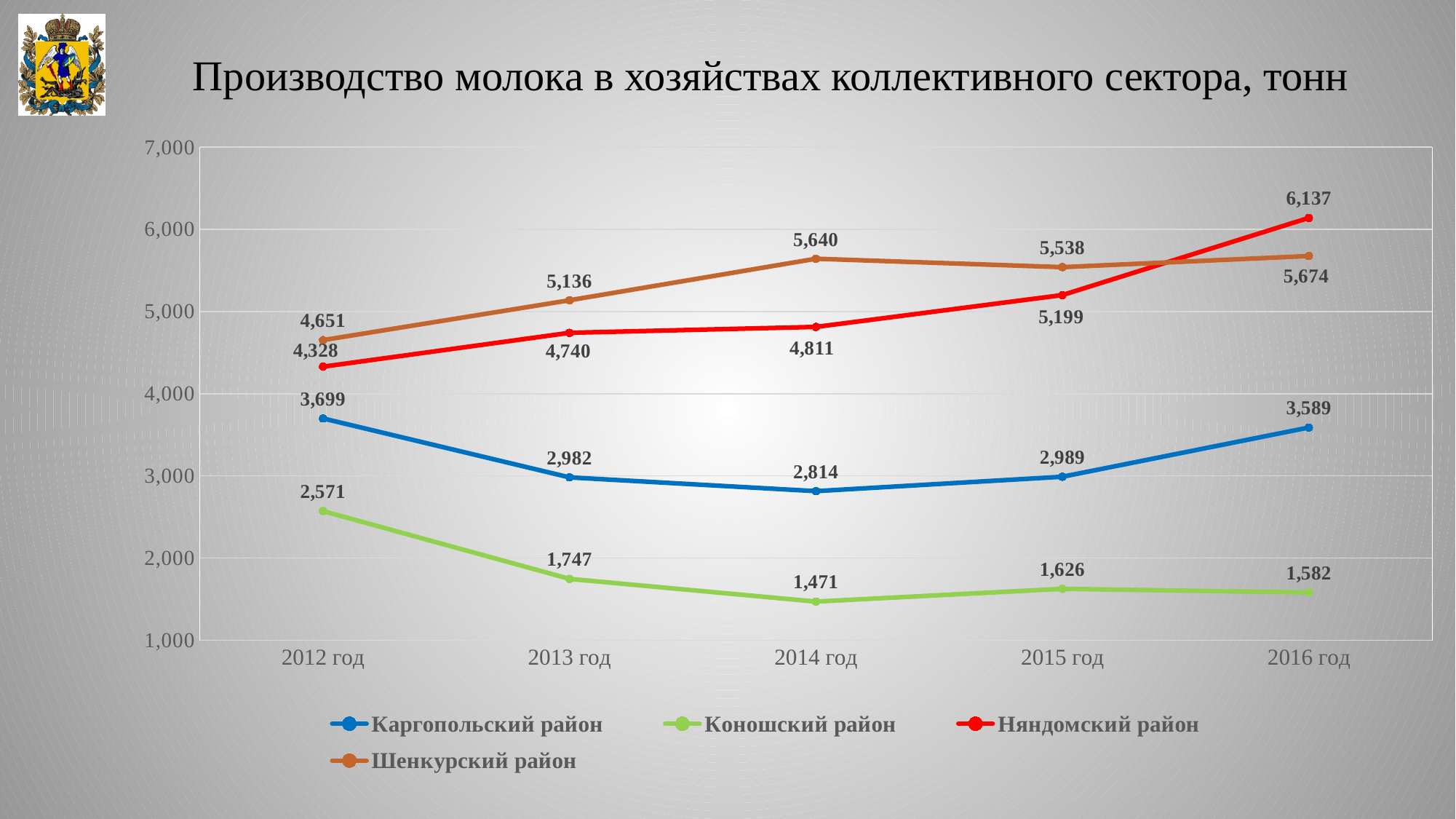
How many years are shown on the x axis? 5 In which year did Коношский район have its lowest value? 2014 год What is the difference between the 2012 год and 2016 год values for Каргопольский район? 110 Does the value for Няндомский район rise or fall from 2012 год to 2016 год? Rises What was milk production in Няндомский район in 2016 год? 6,137 By how much did the value for Няндомский район increase from 2015 год to 2016 год? 938 How many series does the legend list? 4 What kind of chart is shown on the slide? Line chart What value is shown for Шенкурский район in 2013 год? 5,136 What value is shown for Коношский район in 2014 год? 1,471 In 2015 год, which had the larger value: Шенкурский район or Няндомский район? Шенкурский район In which year did Каргопольский район have its highest value? 2012 год